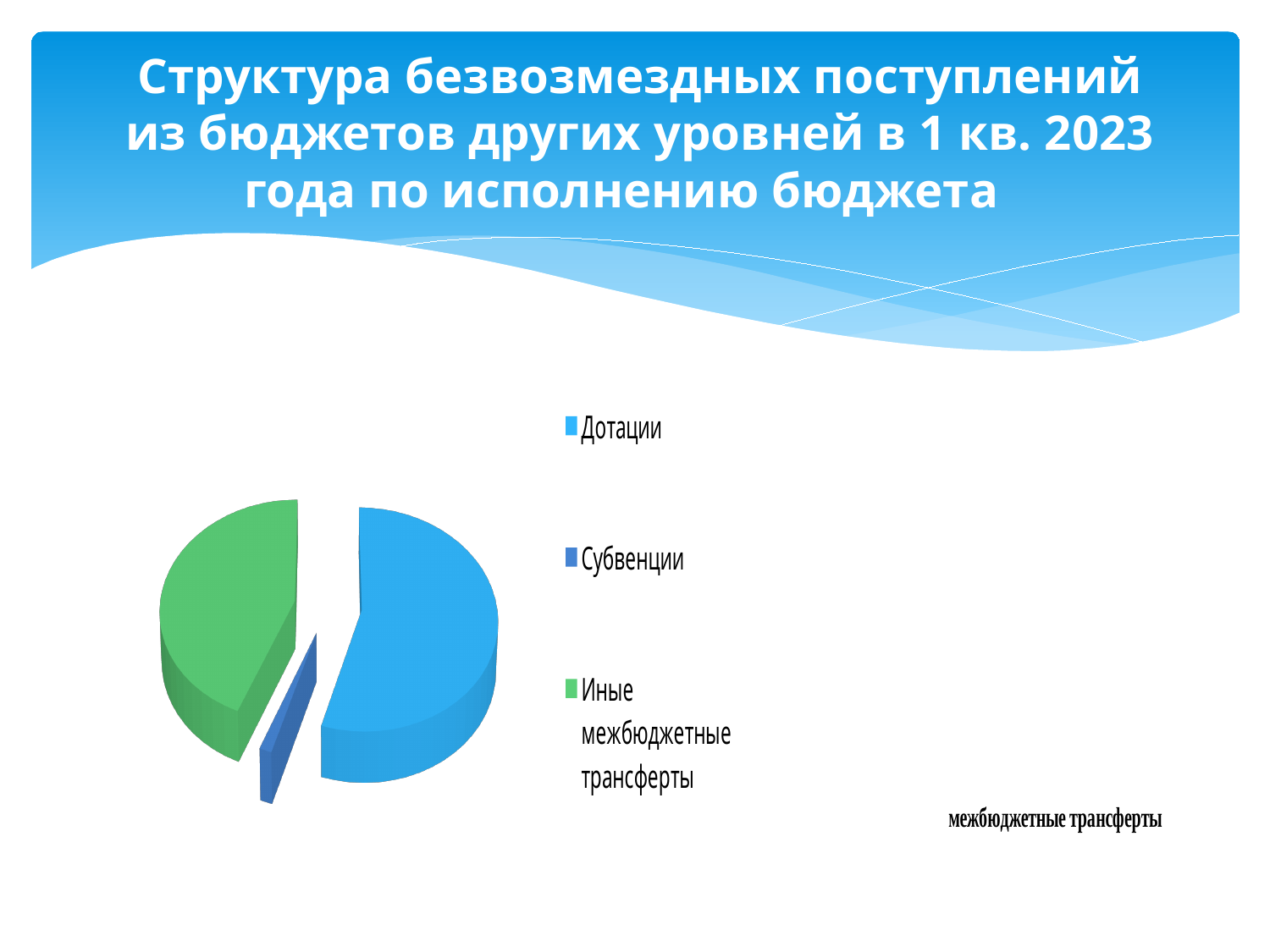
What colour is the Иные межбюджетные трансферты slice in the pie chart? green What kind of chart is shown on the slide? pie chart Which slice is larger, Дотации or Иные межбюджетные трансферты? Дотации What colour is the Дотации slice in the pie chart? light blue Which slice is larger, Дотации or Субвенции? Дотации How many slices does the pie chart have? 3 Which slice is larger, Иные межбюджетные трансферты or Субвенции? Иные межбюджетные трансферты Which category has the smallest slice in the pie chart? Субвенции How many entries does the legend of the pie chart list? 3 Which category has the largest slice in the pie chart? Дотации